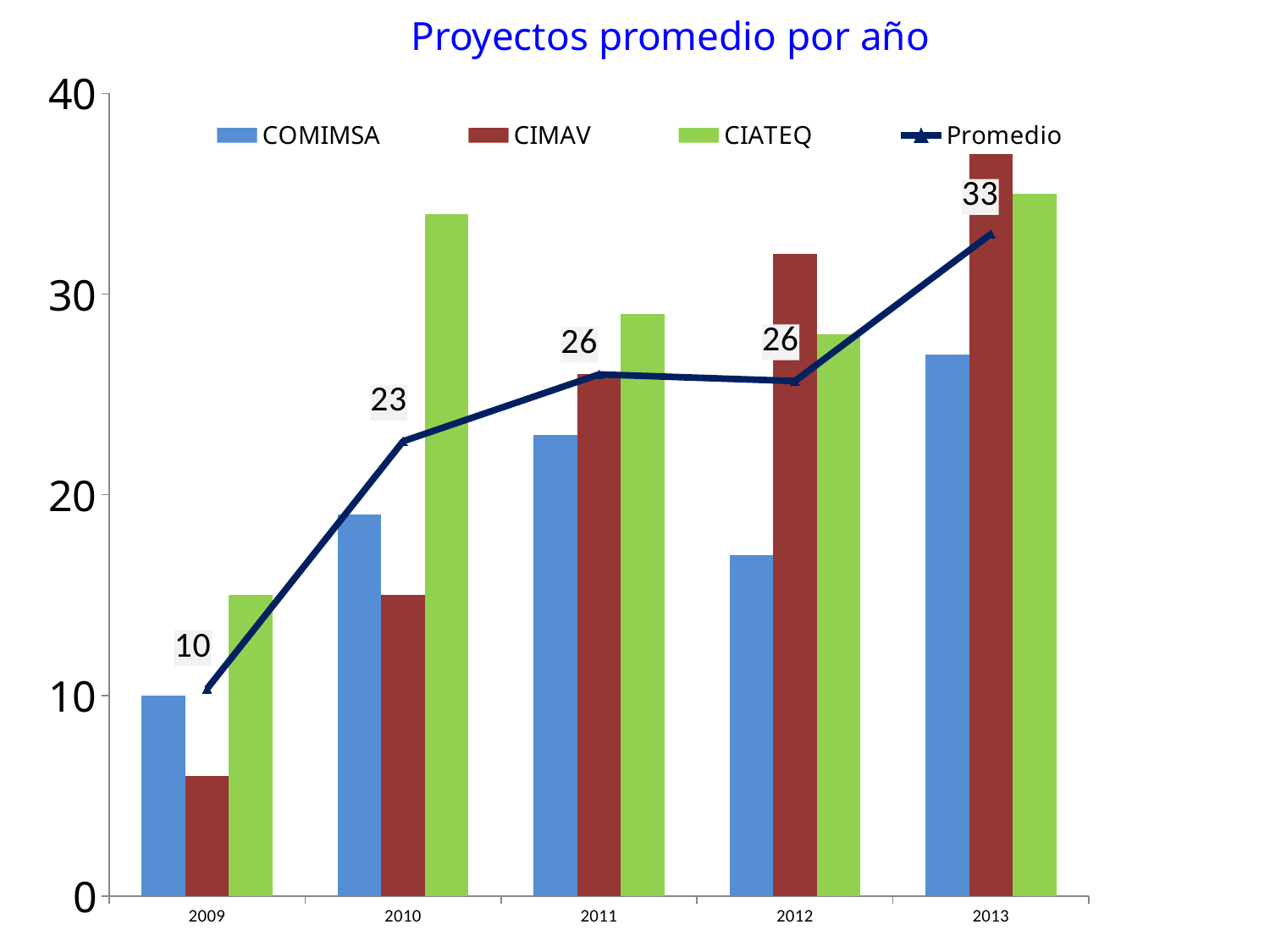
In which year is the Promedio line highest? 2013 Does the Promedio line generally rise or fall from 2009 to 2013? rise Is the value for CIMAV in 2009 greater or less than 10? less How many series does the legend list? 4 What is the Promedio value for 2010? 23 What is the Promedio value for 2009? 10 How many years are shown on the x axis? 5 Is the value for CIATEQ in 2010 greater or less than 30? greater In 2010, which is larger: the CIATEQ bar or the CIMAV bar? CIATEQ What is the difference between the Promedio values for 2013 and 2009? 23 In which year is the Promedio line lowest? 2009 What is the Promedio value for 2013? 33